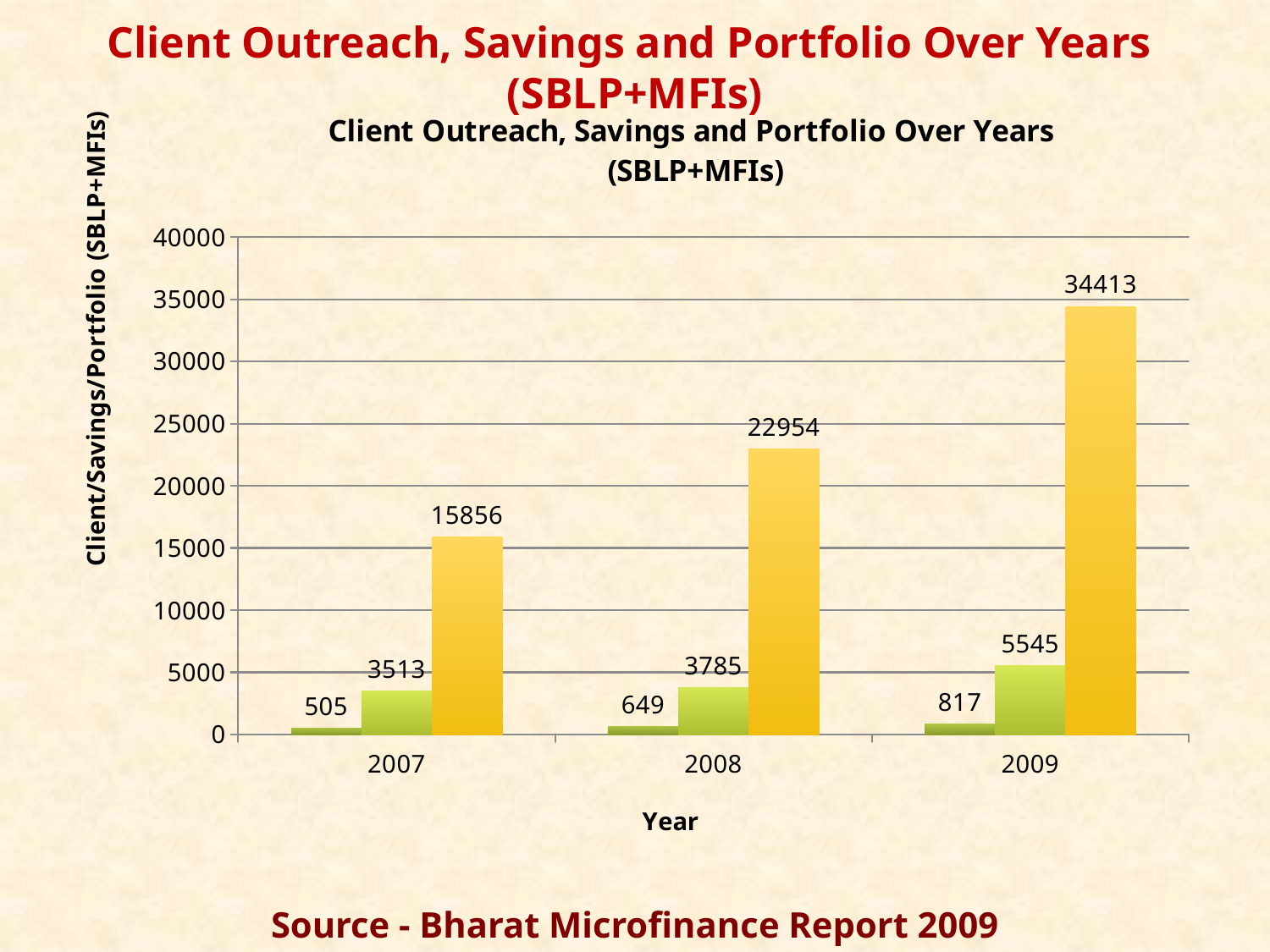
What is the difference between the yellow bar values for 2009 and 2008? 11459 In which year is the dark green bar lowest? 2007 How many years are shown on the x axis? 3 Do the yellow bar values rise or fall from 2007 to 2009? Rise Which is larger, the yellow bar for 2007 or the yellow bar for 2008? 2008 Is the value of the yellow bar for 2008 greater or less than 20000? greater What is the difference between the light green bar values for 2009 and 2007? 2032 In which year is the yellow bar highest? 2009 What is the value of the light green bar for 2008? 3785 What kind of chart is shown on the slide? Bar chart What is the value of the yellow bar for 2009? 34413 What is the value of the dark green bar for 2007? 505